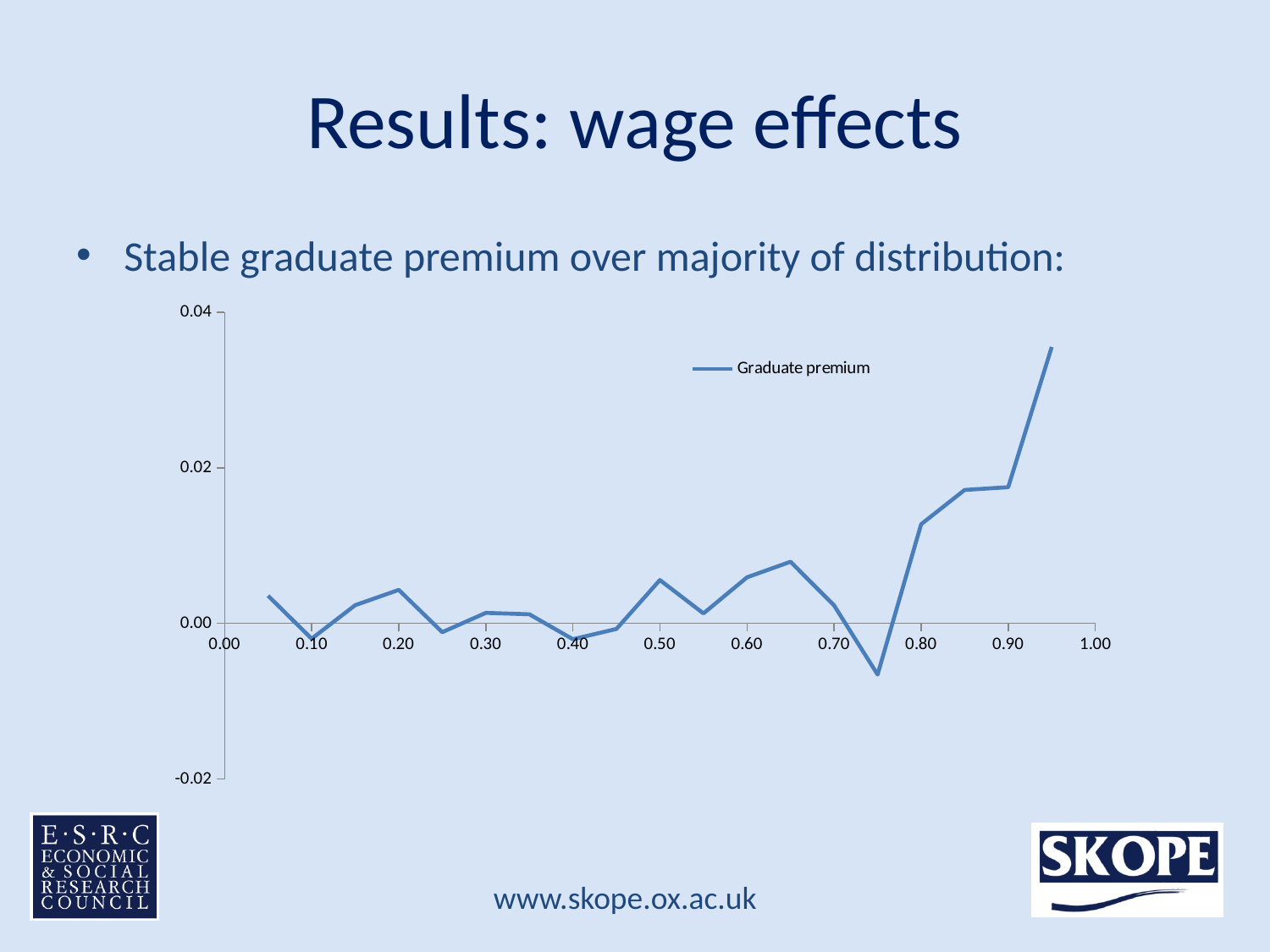
Is the Graduate premium value at x = 0.80 greater or less than 0.02? less Does the Graduate premium line rise or fall between x = 0.75 and x = 0.95? rise What is the name of the series shown in the chart legend? Graduate premium What kind of chart is shown on the slide? line chart Which is larger, the Graduate premium value at x = 0.95 or at x = 0.05? 0.95 At which x-axis value does the Graduate premium line reach its highest point? 0.95 Is the Graduate premium value at x = 0.50 greater or less than 0.00? greater Is the Graduate premium value at x = 0.75 greater or less than 0.00? less Which is larger, the Graduate premium value at x = 0.50 or at x = 0.75? 0.50 At which x-axis value does the Graduate premium line reach its lowest point? 0.75 How many series does the chart legend list? 1